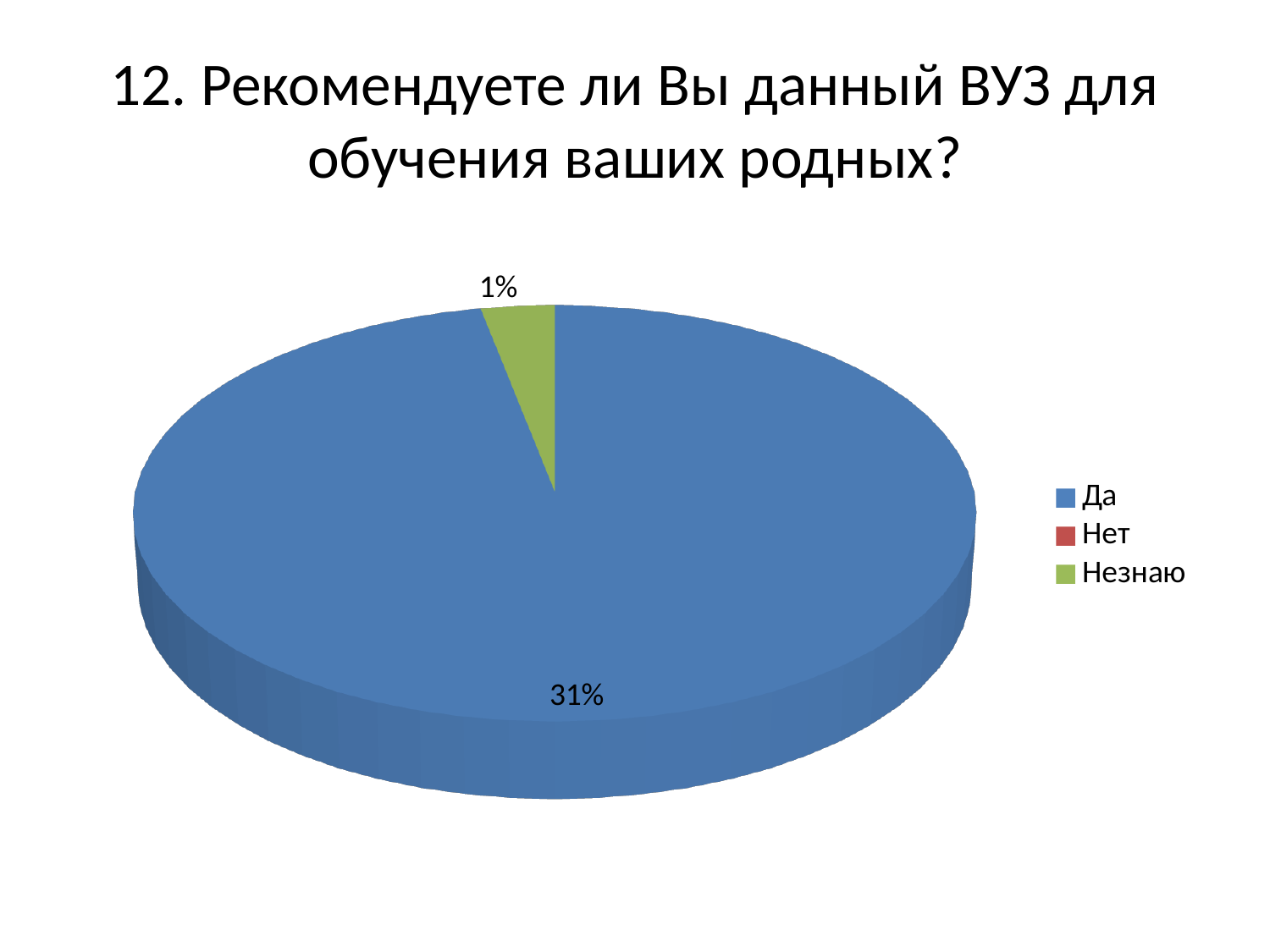
What is the difference between the labelled values for "Да" and "Незнаю"? 30% Which category has the largest slice of the pie? Да Which is larger, the slice for "Да" or the slice for "Незнаю"? Да What colour is the slice for "Да"? blue How many categories does the legend of the pie chart list? 3 Which legend entry is shown in green? Незнаю What value is labelled on the slice for "Да"? 31% What kind of chart is shown on the slide? pie chart What is the title of the slide? 12. Рекомендуете ли Вы данный ВУЗ для обучения ваших родных? What value is labelled on the slice for "Незнаю"? 1%